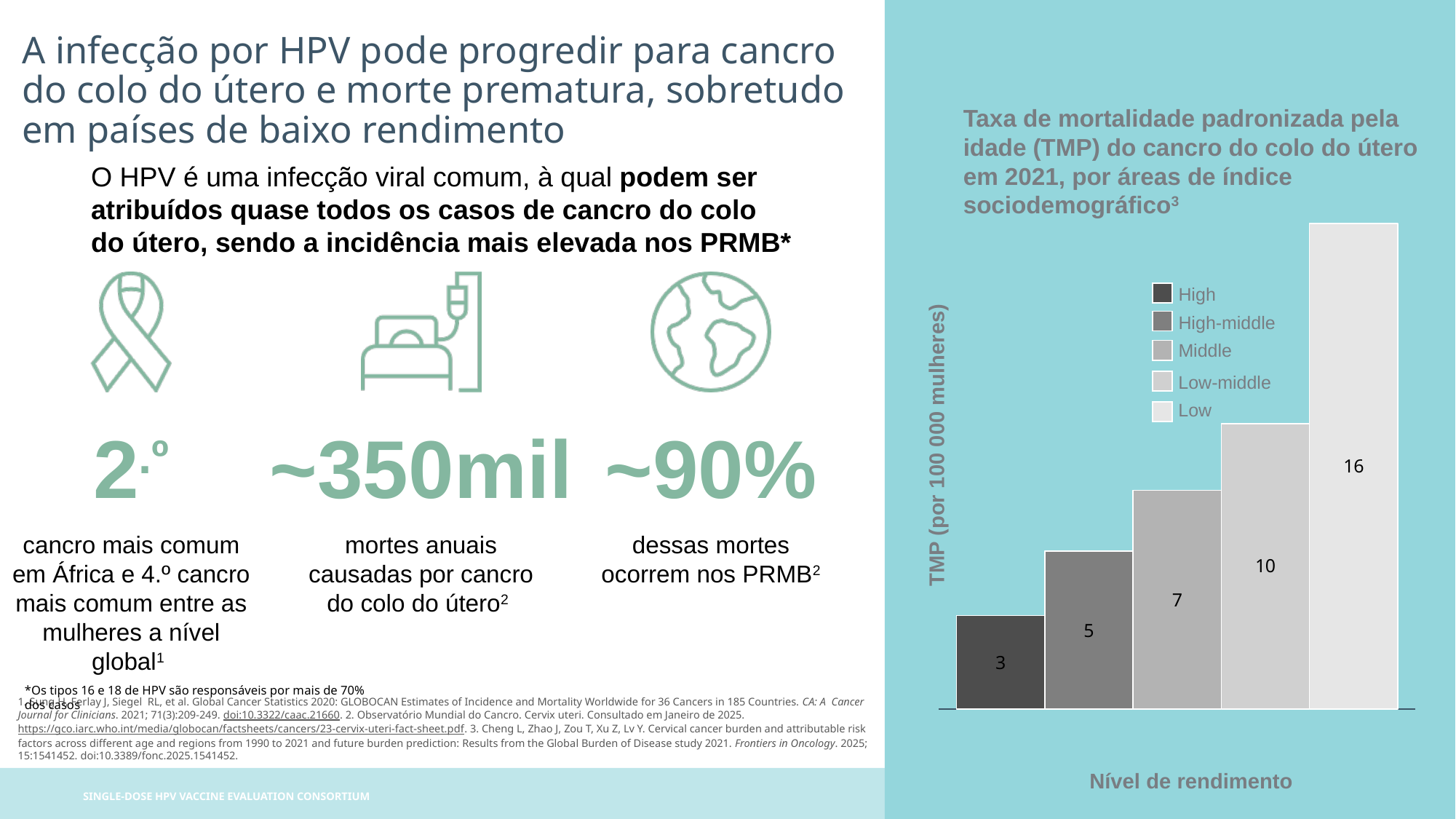
How many entries does the legend list? 5 What type of chart is shown on the slide? Bar chart What is the difference in TMP between the Low and High income levels? 13 What is the TMP value for the High income level? 3 What is the difference in TMP between the Low-middle and High-middle income levels? 5 What is the TMP value for the Middle income level? 7 Which income level has the highest TMP? Low How many income levels are shown in the chart? 5 Which income level has the lowest TMP? High Do the TMP values rise or fall from High to Low income level? Rise What is the TMP value for the Low income level? 16 Which has a higher TMP, Middle or High-middle? Middle